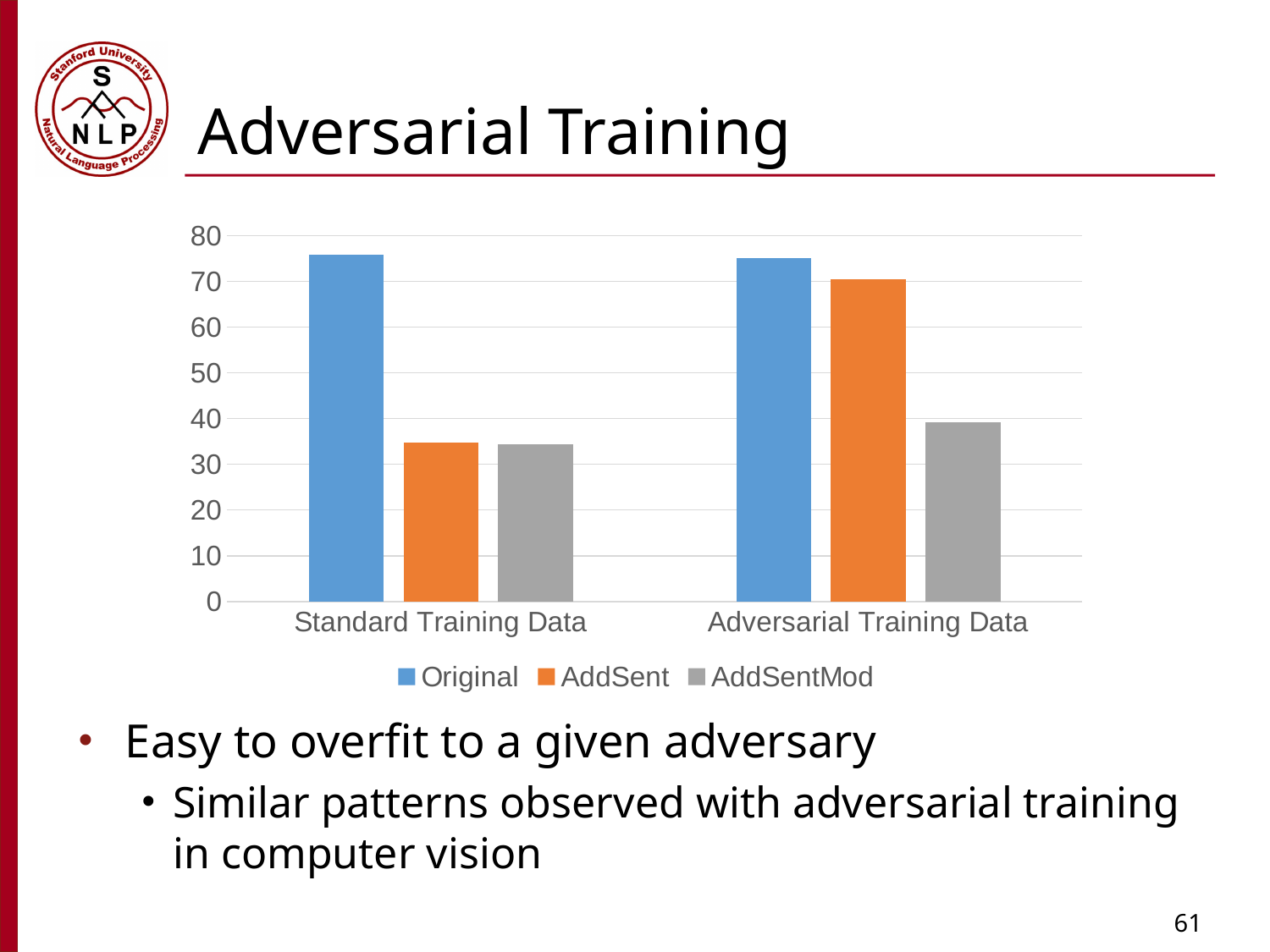
Within Adversarial Training Data, which series has the lowest value? AddSentMod Is the value for Original under Standard Training Data greater or less than 70? greater Is the value for AddSentMod under Adversarial Training Data greater or less than 50? less What colour represents the Original series in the chart? blue Which is larger: the AddSent value for Standard Training Data or the AddSent value for Adversarial Training Data? Adversarial Training Data Is the value for AddSent under Standard Training Data greater or less than 40? less Which is larger: the AddSentMod value for Standard Training Data or the AddSentMod value for Adversarial Training Data? Adversarial Training Data How many series does the chart's legend list? 3 Within Standard Training Data, which series has the highest value? Original What kind of chart is shown on the slide? bar chart How many categories are shown on the x axis of the chart? 2